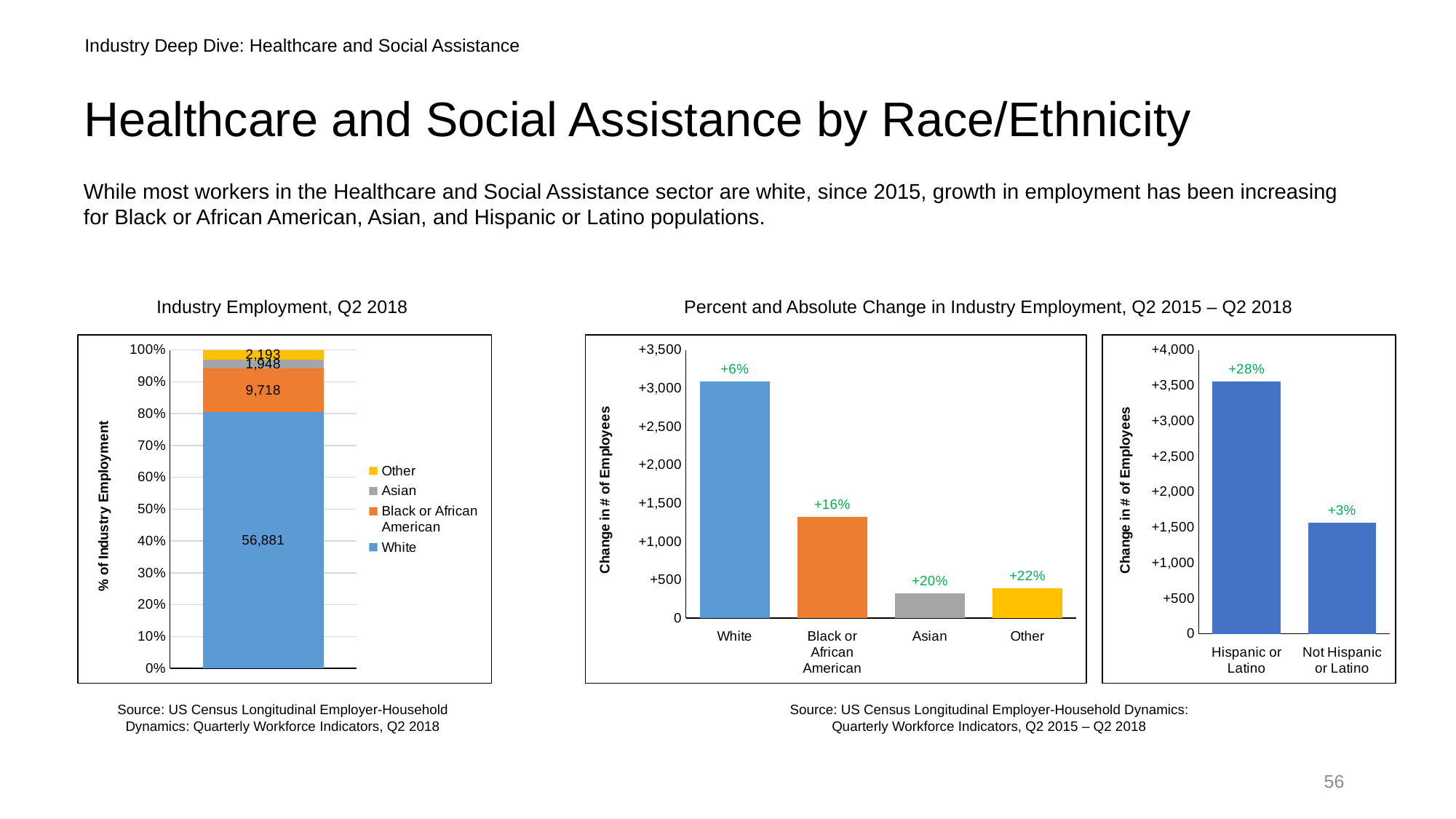
In the middle chart (Percent and Absolute Change in Industry Employment by race), what percent change is labeled for Asian? +20% In the Industry Employment, Q2 2018 chart, what is the total of all four segments of the stacked bar? 70,740 In the rightmost chart (change in industry employment by Hispanic or Latino status), what percent change is labeled for Hispanic or Latino? +28% How many categories are shown on the x axis of the middle chart (Percent and Absolute Change in Industry Employment by race)? 4 How many series does the legend of the Industry Employment, Q2 2018 chart list? 4 In the Industry Employment, Q2 2018 chart, what is the value shown for Other? 2,193 In the middle chart (Percent and Absolute Change in Industry Employment by race), which category has the highest change in # of employees? White In the Industry Employment, Q2 2018 chart, what is the value shown for White? 56,881 In the rightmost chart (change in industry employment by Hispanic or Latino status), is the change in # of employees for Not Hispanic or Latino greater or less than 2,000? less In the middle chart (Percent and Absolute Change in Industry Employment by race), is the change in # of employees for White greater or less than 3,000? greater In the Industry Employment, Q2 2018 chart, what is the difference between the Black or African American value and the Asian value? 7,770 In the Industry Employment, Q2 2018 chart, what is the value shown for Black or African American? 9,718